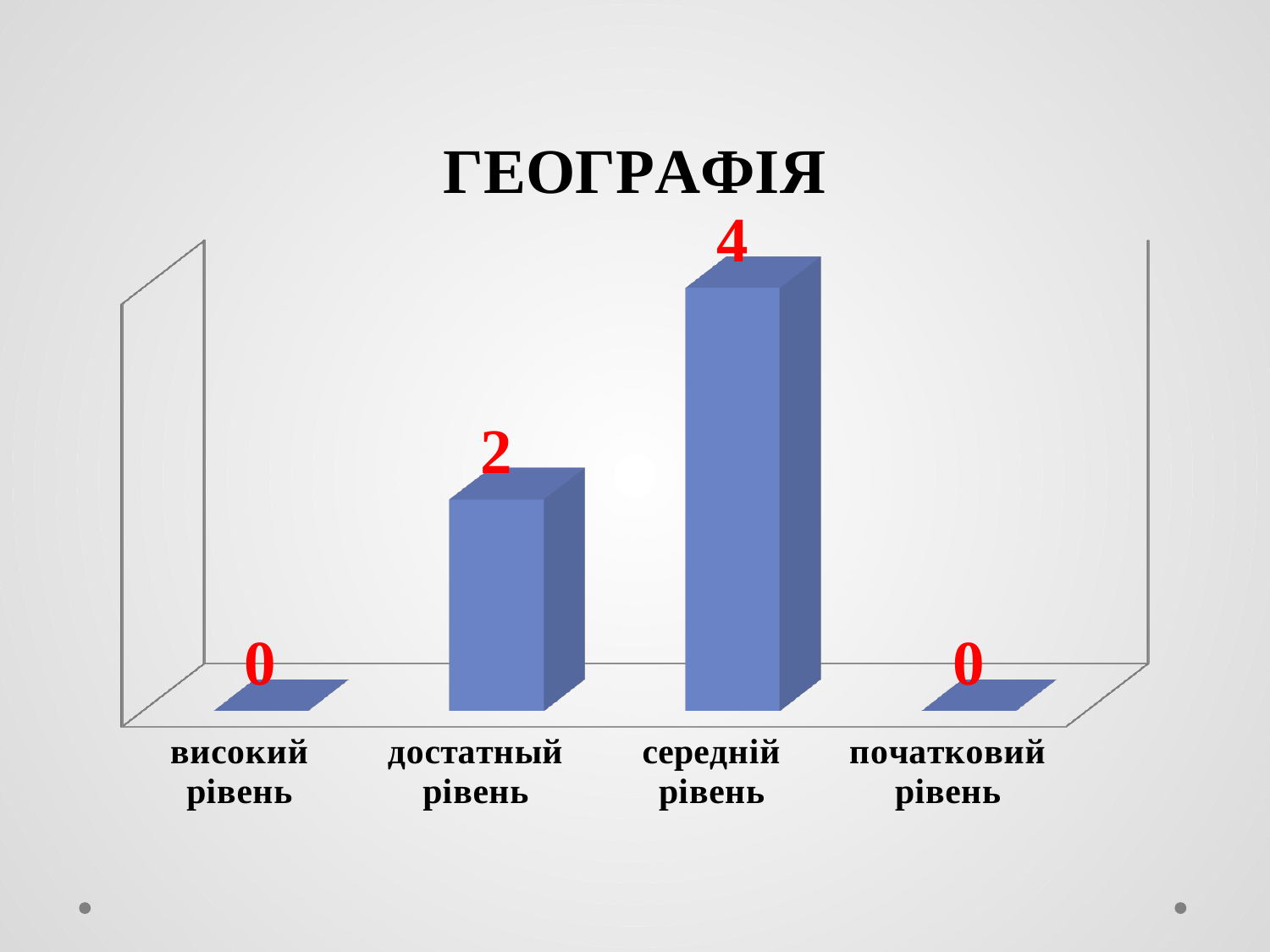
What is the value for достатный рівень? 2 What is the value for початковий рівень? 0 Which category has the highest value? середній рівень What is the value for високий рівень? 0 How many categories are shown on the x axis? 4 How many categories have a value of 0? 2 What is the value for середній рівень? 4 What is the difference between the values for середній рівень and достатный рівень? 2 What kind of chart is shown on the slide? bar chart What is the title of the chart? ГЕОГРАФІЯ Which is larger, the value for достатный рівень or the value for середній рівень? середній рівень What is the total of all four values shown on the chart? 6